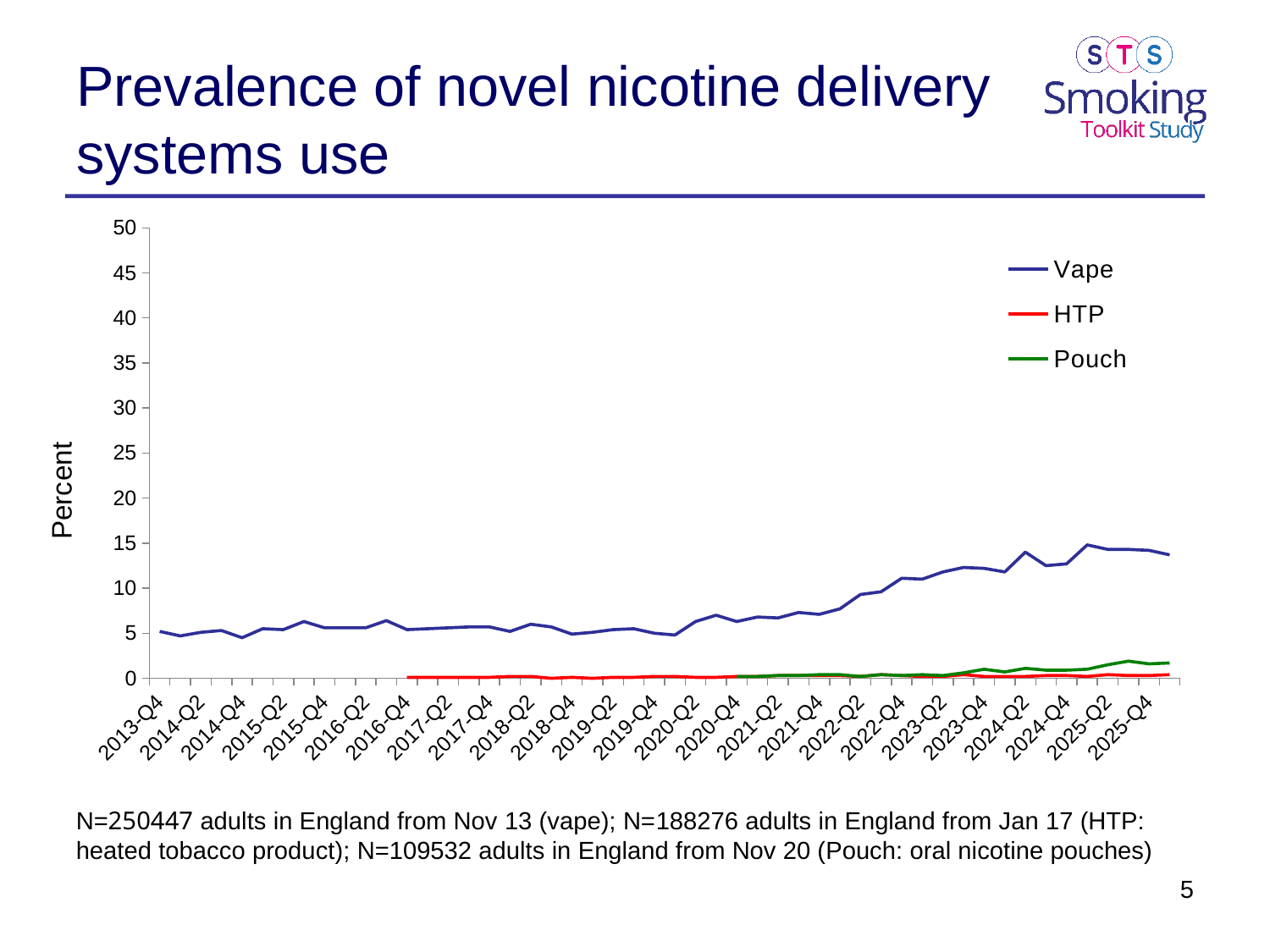
Is the value for Vape at 2025-Q2 greater or less than 10? greater How many series does the legend list? 3 Which is larger at 2025-Q4, the value for Vape or the value for Pouch? Vape Which series are listed in the legend? Vape, HTP, Pouch Is the value for Pouch at 2025-Q4 greater or less than 5? less Which series has the highest values across the chart? Vape What kind of chart is shown on the slide? Line chart Does the Vape series generally rise or fall from 2020-Q2 to 2025-Q2? Rise What is the highest tick value shown on the vertical axis? 50 Which is larger at 2024-Q2, the value for Pouch or the value for HTP? Pouch What is the label on the vertical axis? Percent Is the value for Vape at 2013-Q4 greater or less than 10? less